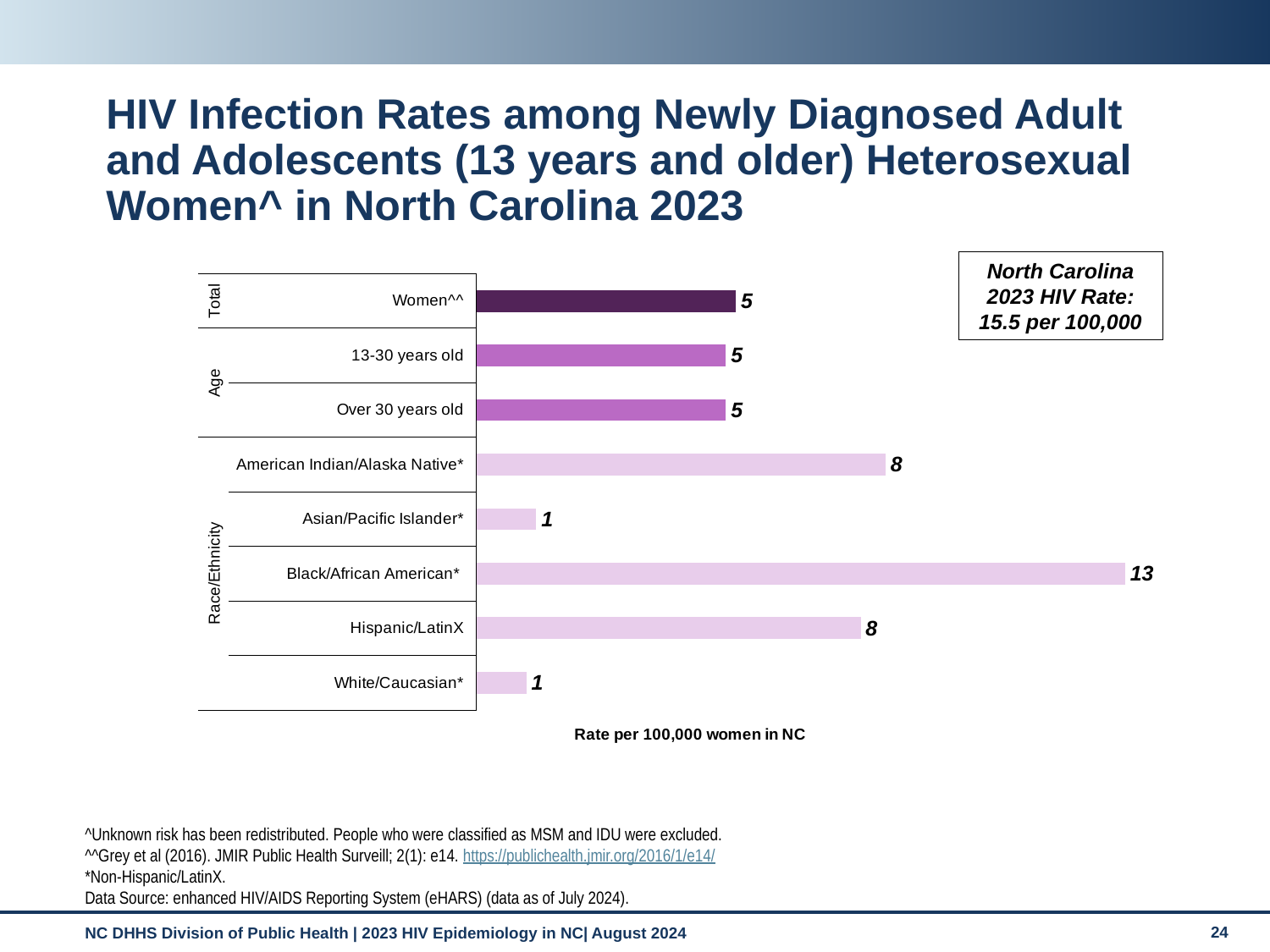
What is the difference between the rates for Hispanic/LatinX women and White/Caucasian* women? 7 What is the label on the horizontal axis of the chart? Rate per 100,000 women in NC What is the overall North Carolina 2023 HIV rate shown in the text box? 15.5 per 100,000 What is the HIV infection rate for Hispanic/LatinX women? 8 Which race/ethnicity category has the highest HIV infection rate? Black/African American* What is the HIV infection rate for women 13-30 years old? 5 What is the HIV infection rate for Black/African American* women? 13 How many categories are plotted in the chart? 8 What kind of chart is shown on the slide? Bar chart Which is larger, the rate for American Indian/Alaska Native* women or the rate for Asian/Pacific Islander* women? American Indian/Alaska Native* What is the difference between the rates for Black/African American* women and American Indian/Alaska Native* women? 5 What is the HIV infection rate for White/Caucasian* women? 1